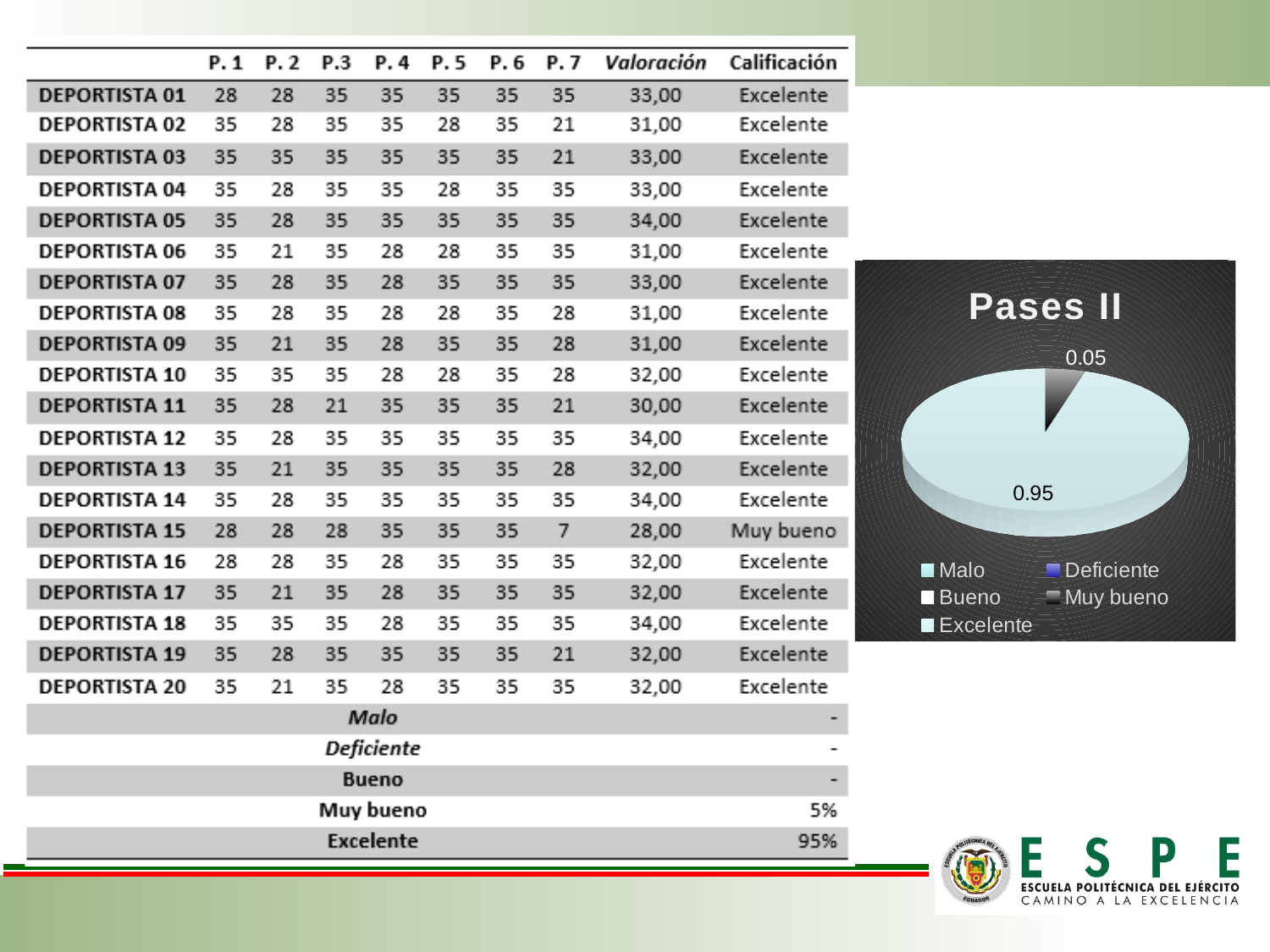
In the Pases II chart, what value is shown for the small dark slice? 0.05 In the Pases II chart, which of the two labelled slices is smaller? Muy bueno What kind of chart is shown on the right of the slide? pie chart In the Pases II chart, what is the value for Muy bueno? 0.05 In the Pases II chart, which category has the largest slice? Excelente How many slices with data labels are visible in the Pases II pie chart? 2 In the Pases II chart, is the Excelente slice larger or smaller than the Muy bueno slice? larger In the Pases II chart, what is the value for Excelente? 0.95 In the Pases II chart, what is the difference between the Excelente and Muy bueno values? 0.90 In the Pases II chart, what value is shown for the largest slice? 0.95 What is the title of the pie chart? Pases II How many entries does the legend of the Pases II chart list? 5